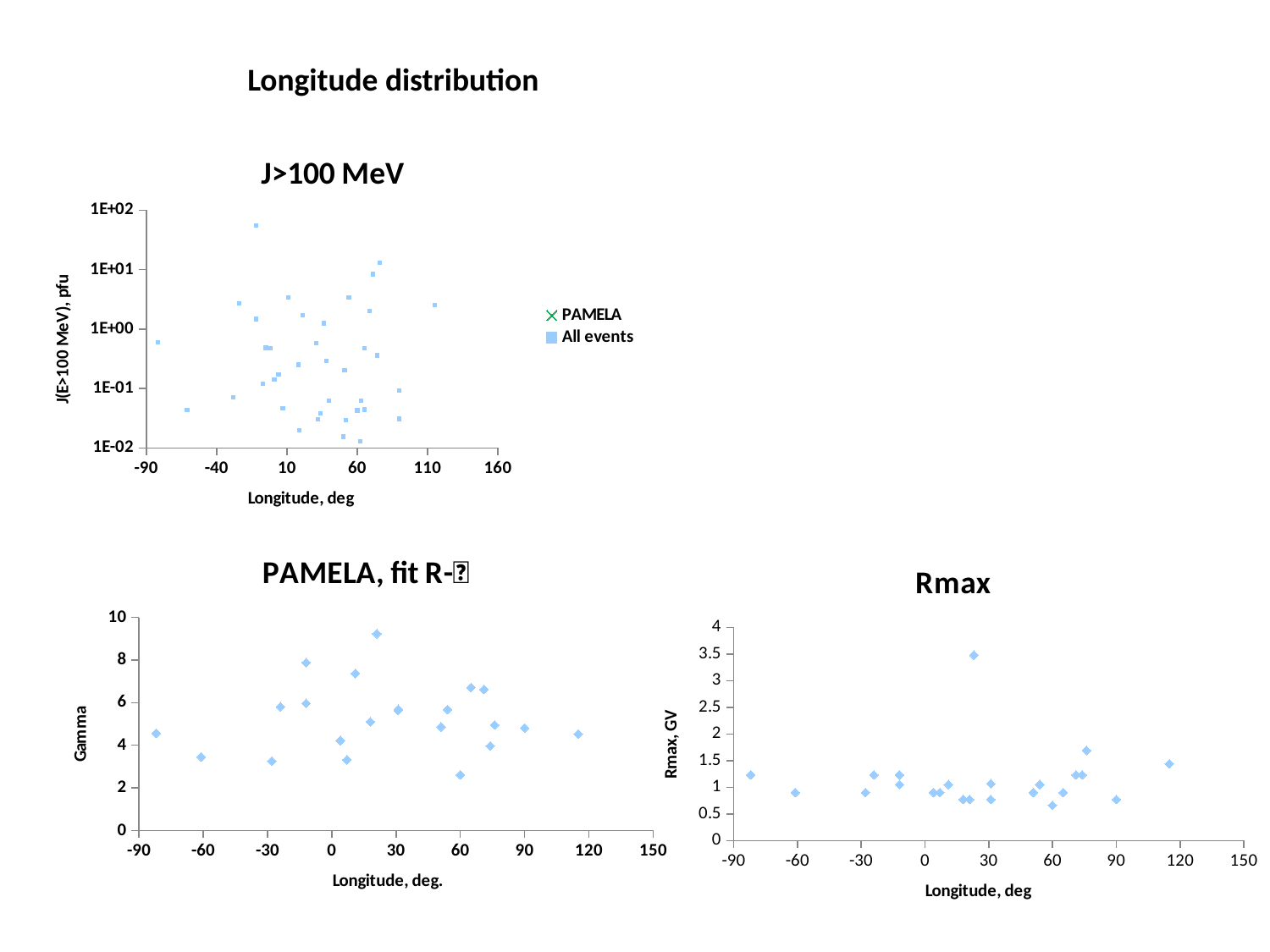
In the PAMELA fit chart (bottom left), is the highest Gamma value greater or less than 8? greater What is the y-axis title of the J>100 MeV chart? J(E>100 MeV), pfu What are the two series named in the legend of the J>100 MeV chart? PAMELA and All events In the PAMELA fit chart (bottom left), is the lowest Gamma value greater or less than 4? less In the Rmax chart, is the highest plotted value greater or less than 3? greater What kind of chart is the J>100 MeV chart? scatter chart How many series does the legend of the J>100 MeV chart list? 2 What kind of chart is the Rmax chart? scatter chart